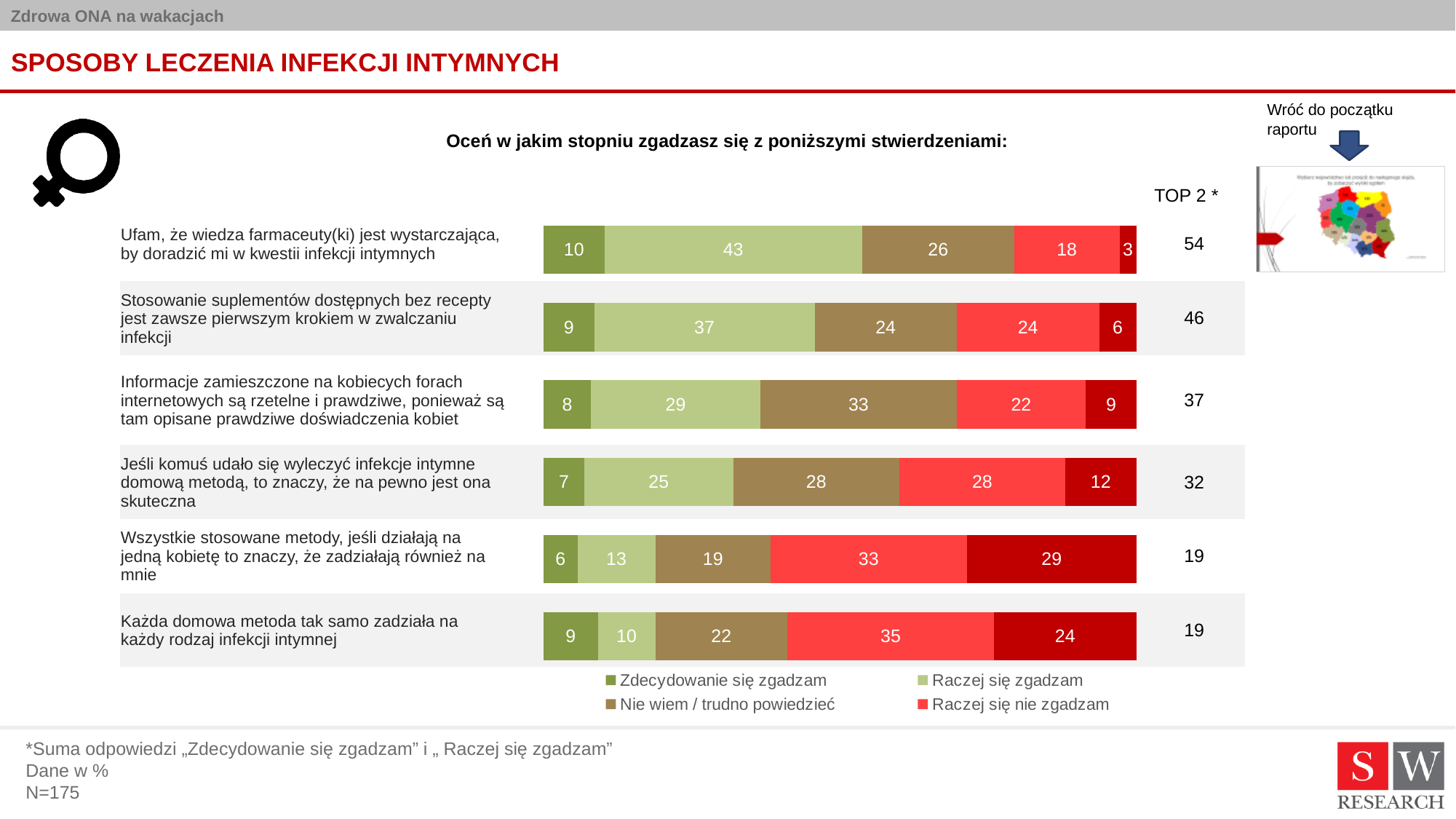
What is the sample size (N) stated on the slide? N=175 What is the 'Zdecydowanie się zgadzam' value for the statement 'Ufam, że wiedza farmaceuty(ki) jest wystarczająca, by doradzić mi w kwestii infekcji intymnych'? 10 What is the 'Raczej się zgadzam' value for the statement 'Stosowanie suplementów dostępnych bez recepty jest zawsze pierwszym krokiem w zwalczaniu infekcji'? 37 How many series does the legend list? 4 What type of chart is shown on the slide? stacked bar chart What is the TOP 2 value for the statement 'Jeśli komuś udało się wyleczyć infekcje intymne domową metodą, to znaczy, że na pewno jest ona skuteczna'? 32 Which statement has the highest TOP 2 value? Ufam, że wiedza farmaceuty(ki) jest wystarczająca, by doradzić mi w kwestii infekcji intymnych Which is larger: the 'Raczej się zgadzam' value for 'Wszystkie stosowane metody, jeśli działają na jedną kobietę...' or for 'Każda domowa metoda tak samo zadziała...'? Wszystkie stosowane metody, jeśli działają na jedną kobietę to znaczy, że zadziałają również na mnie How many statements (categories) are plotted in the chart? 6 Which statement has the highest 'Raczej się nie zgadzam' value? Każda domowa metoda tak samo zadziała na każdy rodzaj infekcji intymnej What is the difference between the TOP 2 values of the first statement (54) and the second statement (46)? 8 What is the 'Nie wiem / trudno powiedzieć' value for the statement 'Informacje zamieszczone na kobiecych forach internetowych są rzetelne i prawdziwe...'? 33